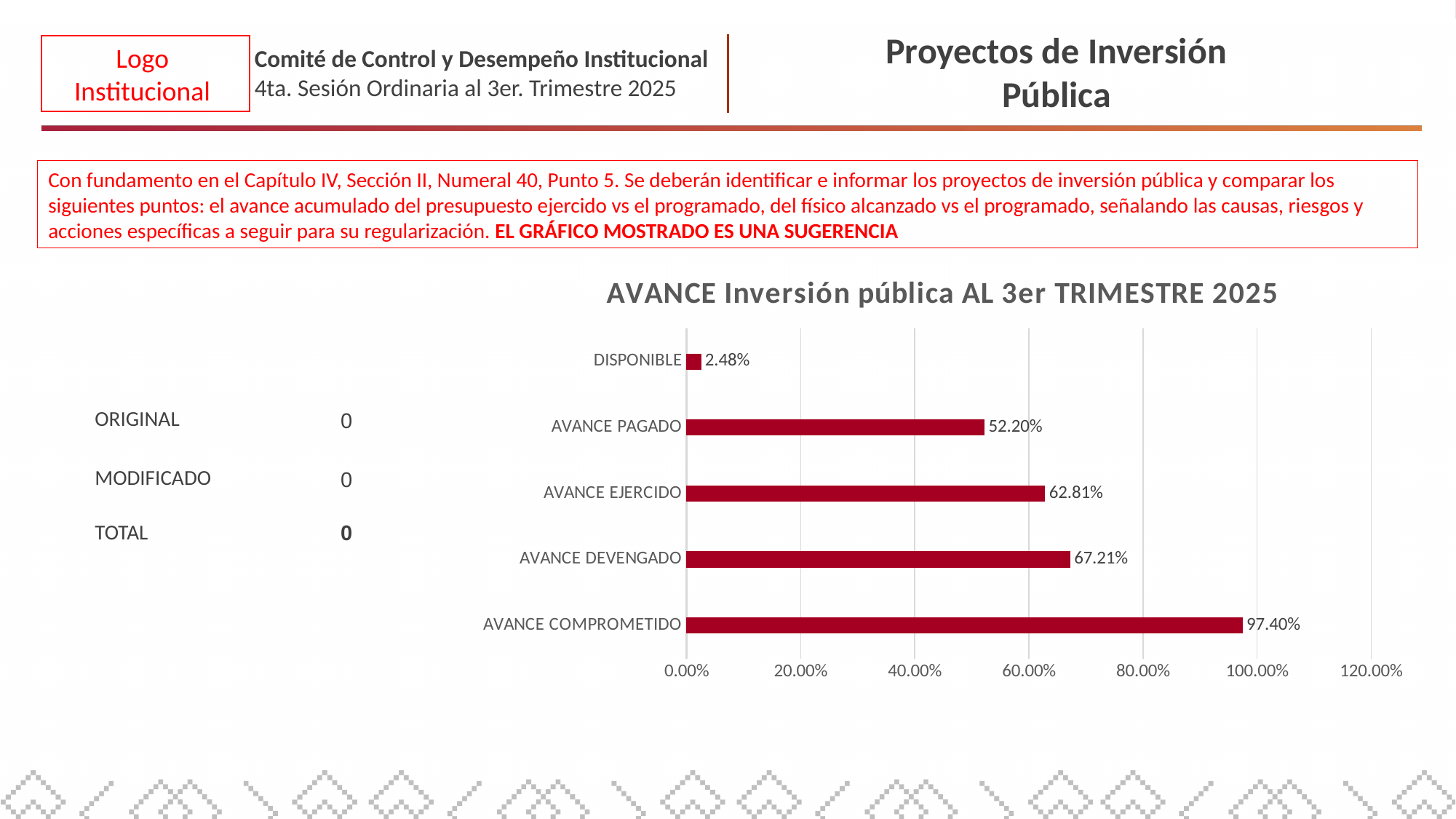
What is the value for AVANCE PAGADO? 52.20% What is the value for AVANCE EJERCIDO? 62.81% What is the value for DISPONIBLE? 2.48% Which category has the lowest value? DISPONIBLE Which is larger, AVANCE PAGADO or AVANCE EJERCIDO? AVANCE EJERCIDO What is the title of the chart? AVANCE Inversión pública AL 3er TRIMESTRE 2025 What is the value for AVANCE DEVENGADO? 67.21% What is the value for AVANCE COMPROMETIDO? 97.40% How many categories are shown in the chart? 5 Which category has the highest value? AVANCE COMPROMETIDO What kind of chart is shown? Bar chart What is the difference between AVANCE DEVENGADO and AVANCE EJERCIDO? 4.40%